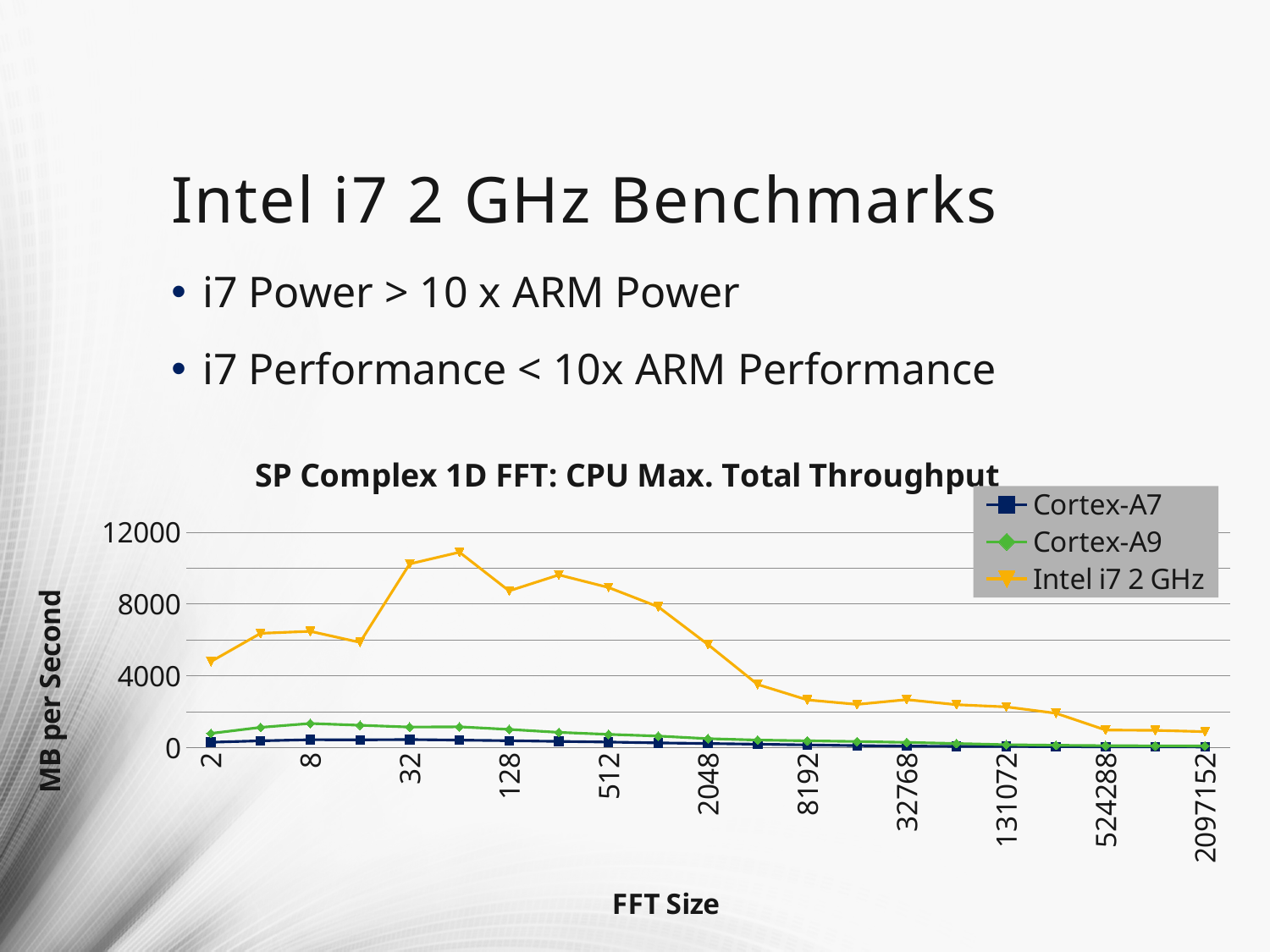
How many series does the chart legend list? 3 Is the value for Intel i7 2 GHz at FFT size 32 greater or less than 8000? greater What is the label of the chart's y axis? MB per Second Is the value for Cortex-A9 at FFT size 8 greater or less than 4000? less Which series has the highest throughput at FFT size 32? Intel i7 2 GHz At FFT size 8, which is larger: Cortex-A9 or Cortex-A7? Cortex-A9 Does the Intel i7 2 GHz series rise or fall from FFT size 512 to FFT size 2097152? fall Is the value for Intel i7 2 GHz at FFT size 8192 greater or less than 4000? less Is the Intel i7 2 GHz value larger at FFT size 32 or at FFT size 2097152? 32 What kind of chart is shown on the slide? Line chart What is the title of the chart? SP Complex 1D FFT: CPU Max. Total Throughput Which series has the lowest throughput across the FFT sizes? Cortex-A7